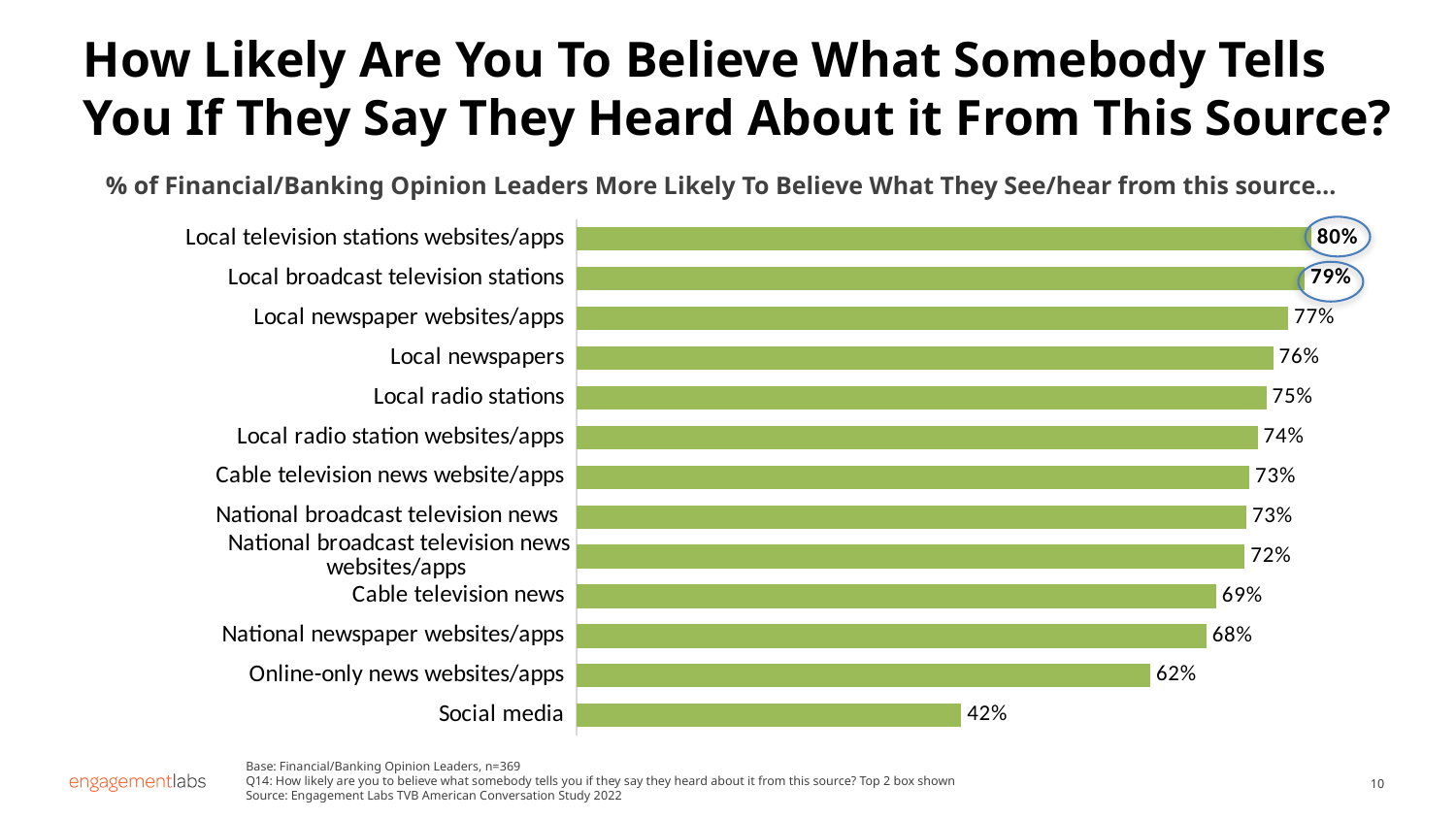
What is the value shown for Local radio stations? 75% What is the difference between the values for Local newspapers and Cable television news? 7 percentage points How many sources are shown in the chart? 13 Which source has the lowest percentage? Social media What is the difference between the values for Local television stations websites/apps and Social media? 38 percentage points Which source has the highest percentage? Local television stations websites/apps What kind of chart is shown on the slide? Bar chart What percentage of Financial/Banking Opinion Leaders are more likely to believe what they hear from Local television stations websites/apps? 80% What is the value shown for Online-only news websites/apps? 62% Which is larger, the value for Local newspaper websites/apps or the value for National newspaper websites/apps? Local newspaper websites/apps Which two values on the chart are circled? 80% and 79% What is the value shown for Social media? 42%